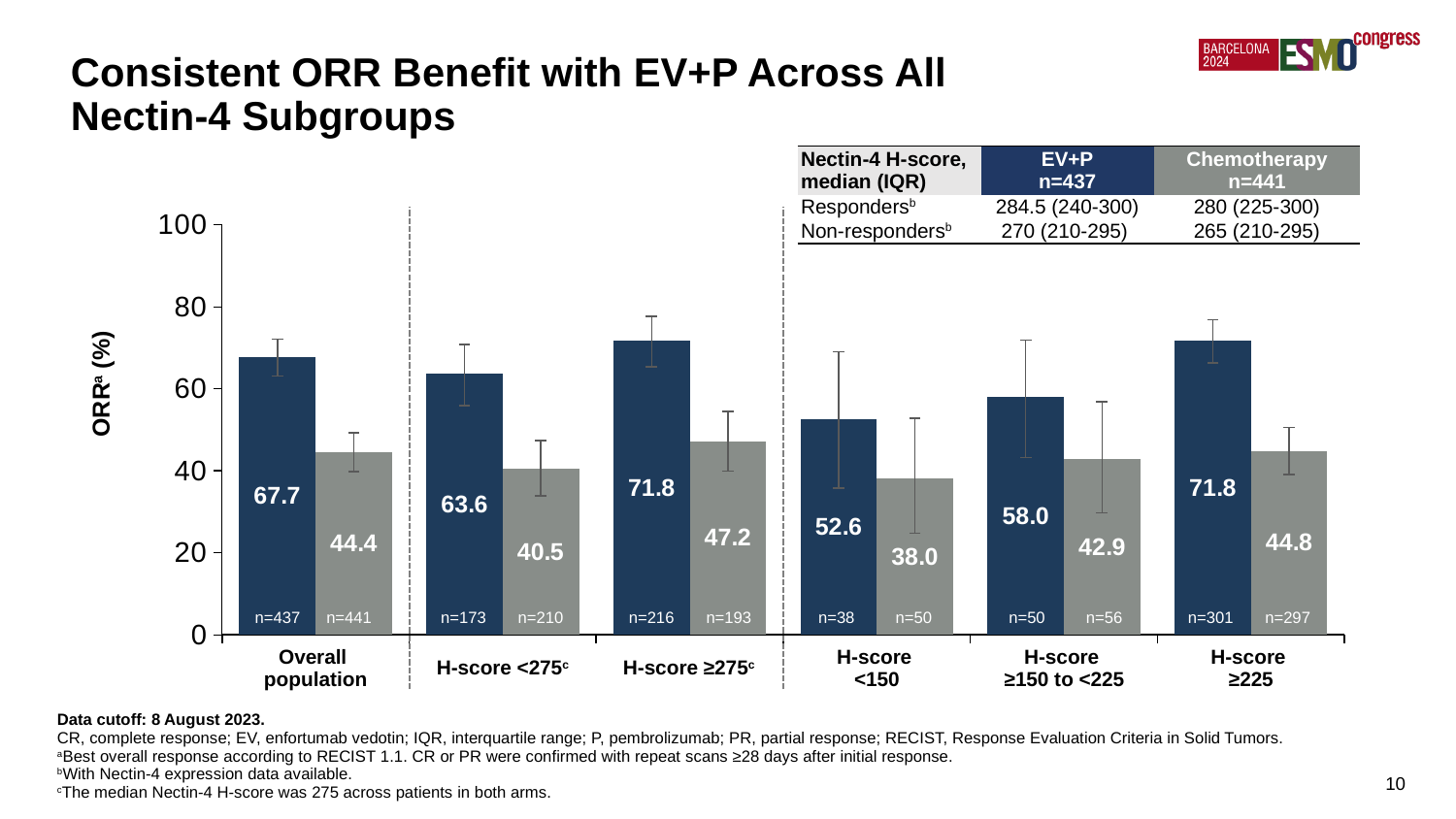
Which is larger: the EV+P ORR in the H-score <275 group or the EV+P ORR in the H-score ≥275 group? H-score ≥275 What is the ORR for the Chemotherapy (gray) bar in the H-score ≥150 to <225 group? 42.9 What is the ORR for the EV+P (dark blue) bar in the Overall population group? 67.7 In which subgroup is the Chemotherapy (gray) ORR highest? H-score ≥275 How many subgroup categories are shown on the x axis? 6 What is the ORR for the EV+P (dark blue) bar in the H-score <150 group? 52.6 What is the ORR for the Chemotherapy (gray) bar in the H-score ≥275 group? 47.2 What is the difference between the EV+P and Chemotherapy ORR values in the Overall population group? 23.3 What is the label of the y axis? ORR (%) In which subgroup is the EV+P (dark blue) ORR lowest? H-score <150 What kind of chart is shown on the slide? bar chart What is the difference between the EV+P and Chemotherapy ORR values in the H-score ≥225 group? 27.0